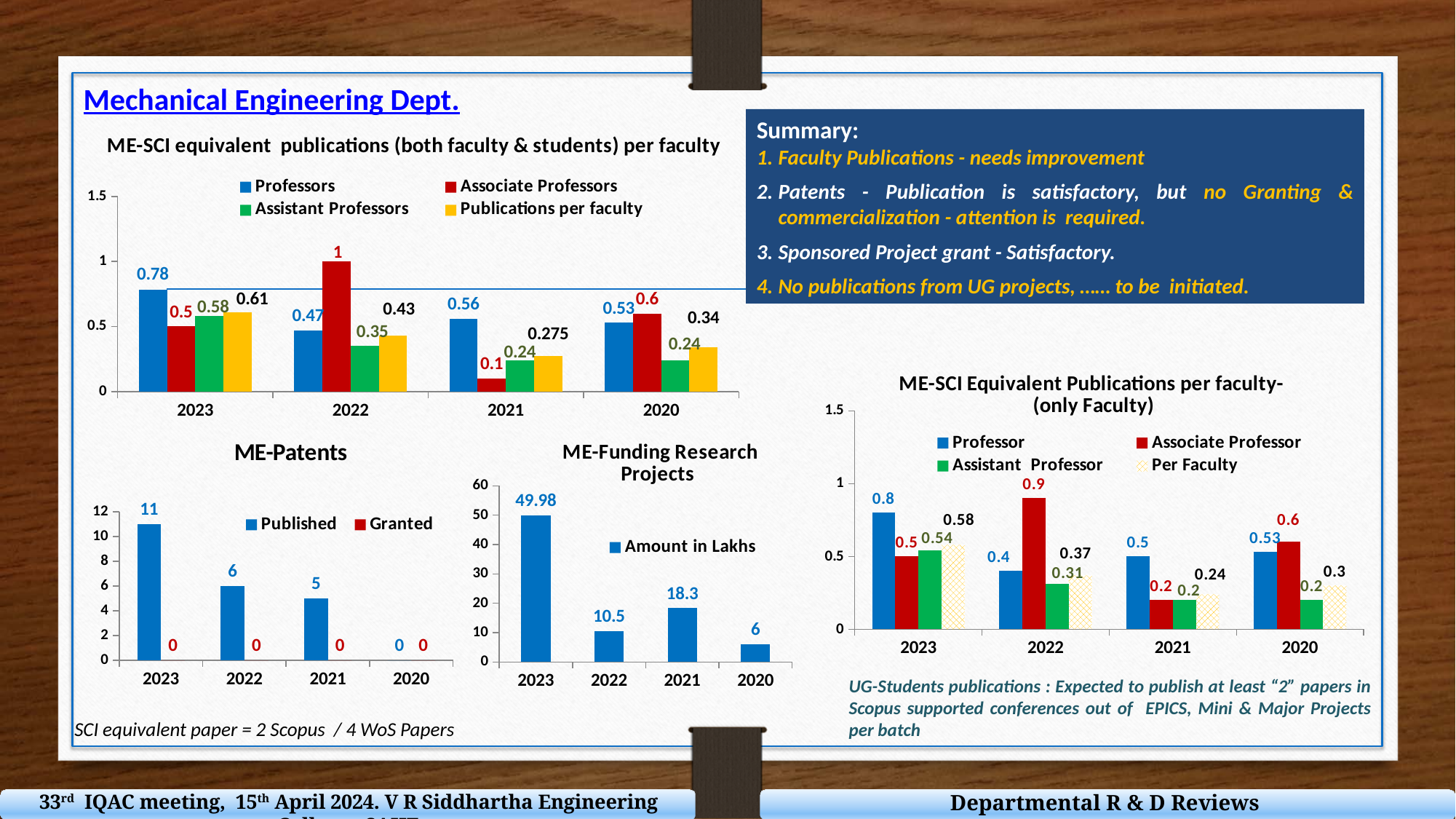
In the ME-Funding Research Projects chart, which year has the highest Amount in Lakhs? 2023 In the 'ME-SCI equivalent publications (both faculty & students) per faculty' chart, what is the value for Associate Professors in 2022? 1 In the 'ME-SCI equivalent publications (both faculty & students) per faculty' chart, what is the difference between the Professors values for 2023 and 2022? 0.31 In the ME-Patents chart, how many patents were published in 2023? 11 In the ME-Patents chart, what is the Granted value for 2022? 0 In the ME-Patents chart, which year has the lowest number of published patents? 2020 In the 'ME-SCI equivalent publications (both faculty & students) per faculty' chart, what is the Publications per faculty value for 2021? 0.275 In the ME-Funding Research Projects chart, is the Amount in Lakhs for 2022 larger or smaller than for 2021? smaller In the ME-Funding Research Projects chart, what is the Amount in Lakhs for 2021? 18.3 What type of chart is the ME-Funding Research Projects chart? bar chart In the 'ME-SCI equivalent publications (both faculty & students) per faculty' chart, how many series does the legend list? 4 In the 'ME-SCI Equivalent Publications per faculty (only Faculty)' chart, what is the Associate Professor value for 2022? 0.9